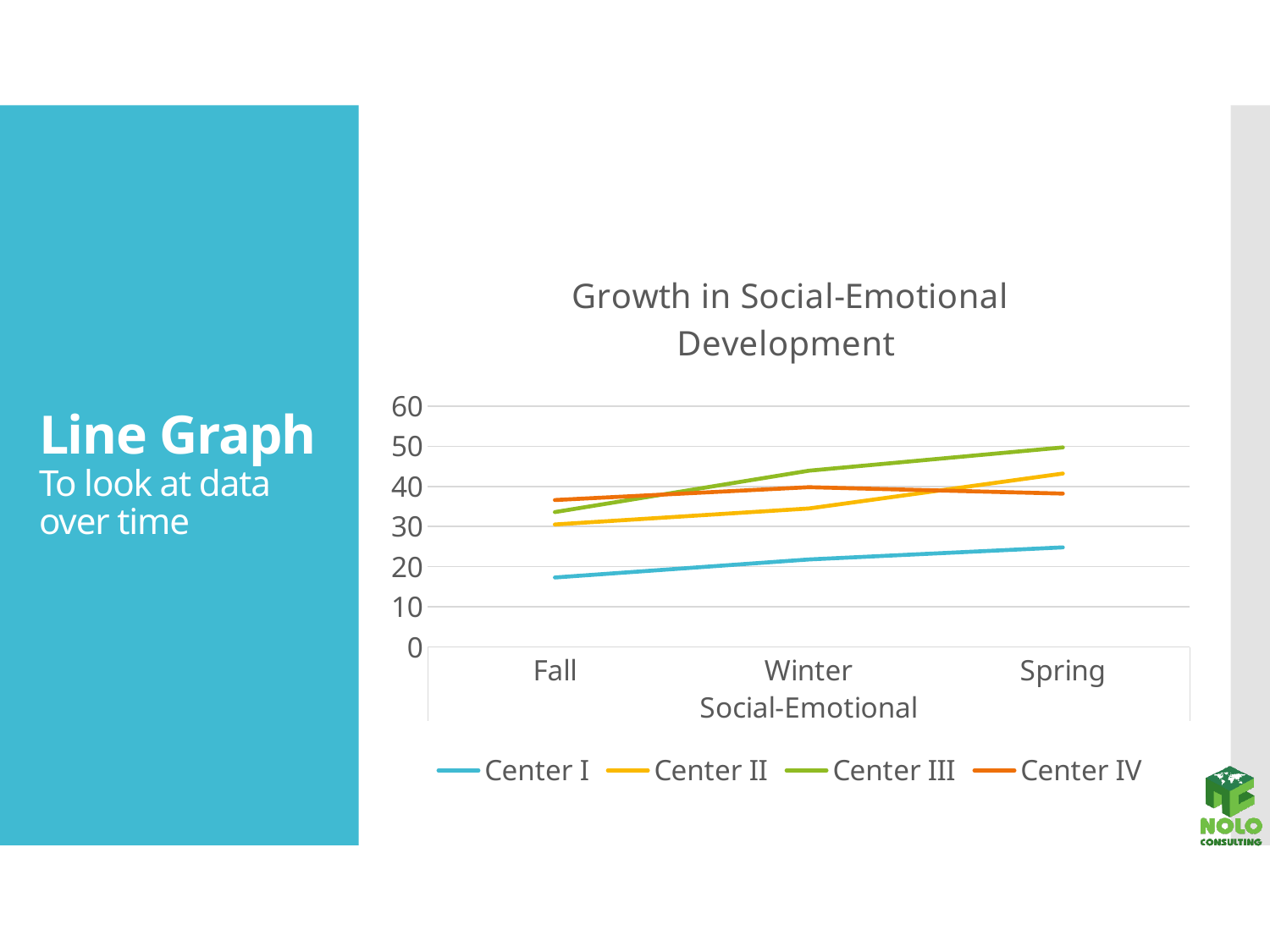
How many series does the legend list? 4 In Spring, which is larger, Center II or Center IV? Center II Which series has the lowest value in Fall? Center I Is the value for Center IV in Fall greater or less than 40? less Is the value for Center III in Winter greater or less than 40? greater What is the title of the chart? Growth in Social-Emotional Development How many points are on the x axis? 3 Which series has the lowest value in Spring? Center I Is the value for Center I in Fall greater or less than 20? less Does the Center I line rise or fall from Fall to Spring? rise Which series has the highest value in Spring? Center III What kind of chart is shown on the slide? line chart